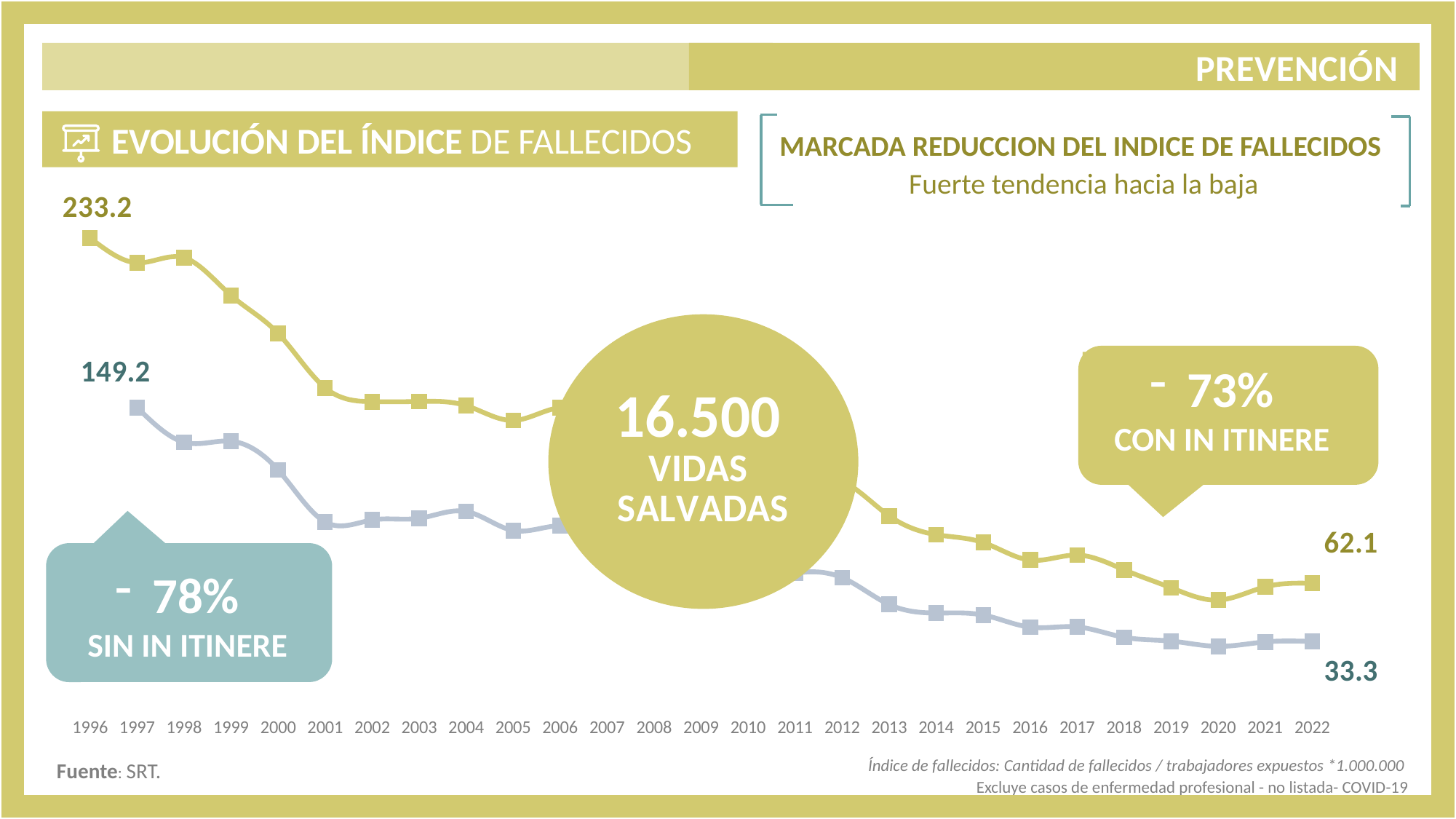
What is the value of the lower (blue-grey) line, the index without in itinere, in 2022? 33.3 What is the difference between the two lines' values in 2022? 28.8 Do the values of the lines rise or fall from 1996 to 2022? fall How many years are shown on the x axis? 27 Which line has the higher value in 1996, the index with in itinere or without in itinere? with in itinere By how much did the index with in itinere (upper line) fall between 1996 and 2022? 171.1 What is the value of the upper (olive) line, the index with in itinere, in 1996? 233.2 What is the value of the upper (olive) line, the index with in itinere, in 2022? 62.1 What percentage reduction does the slide report for the index with in itinere? -73% What kind of chart is shown on the slide? line chart